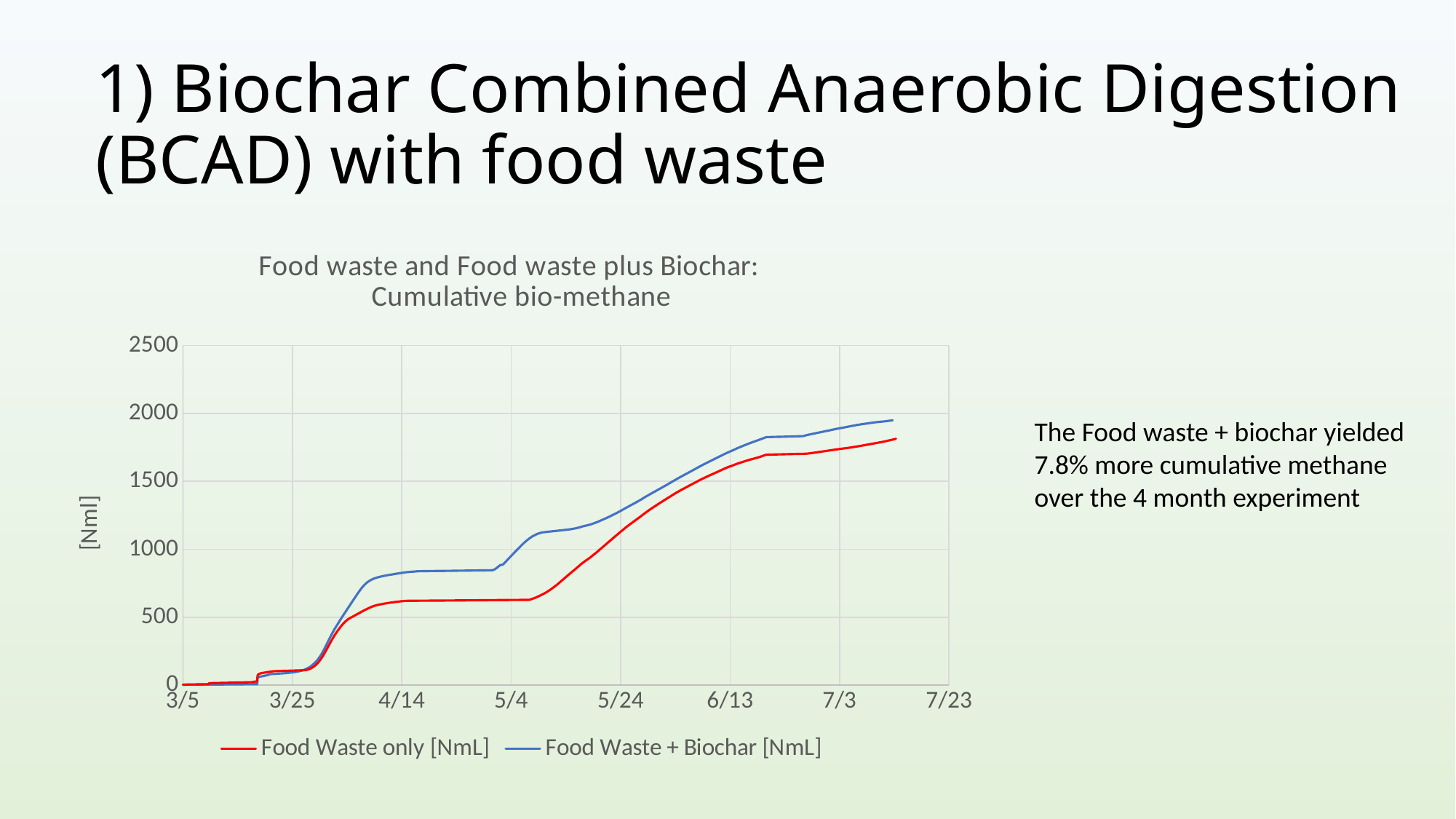
Is the value for Food Waste only [NmL] at 6/13 greater or less than 1500? greater How many series does the legend list? 2 What is the title of the chart? Food waste and Food waste plus Biochar: Cumulative bio-methane Is the value for Food Waste + Biochar [NmL] at 4/14 greater or less than 1000? less Is the value for Food Waste + Biochar [NmL] at 6/13 greater or less than 2000? less Do the values for Food Waste + Biochar [NmL] rise or fall along the x axis? rise Which series ends higher at the last plotted point, Food Waste only [NmL] or Food Waste + Biochar [NmL]? Food Waste + Biochar [NmL] Which series is higher at 5/24, Food Waste only [NmL] or Food Waste + Biochar [NmL]? Food Waste + Biochar [NmL] What is the label on the y axis? [Nml] What kind of chart is shown on the slide? line chart